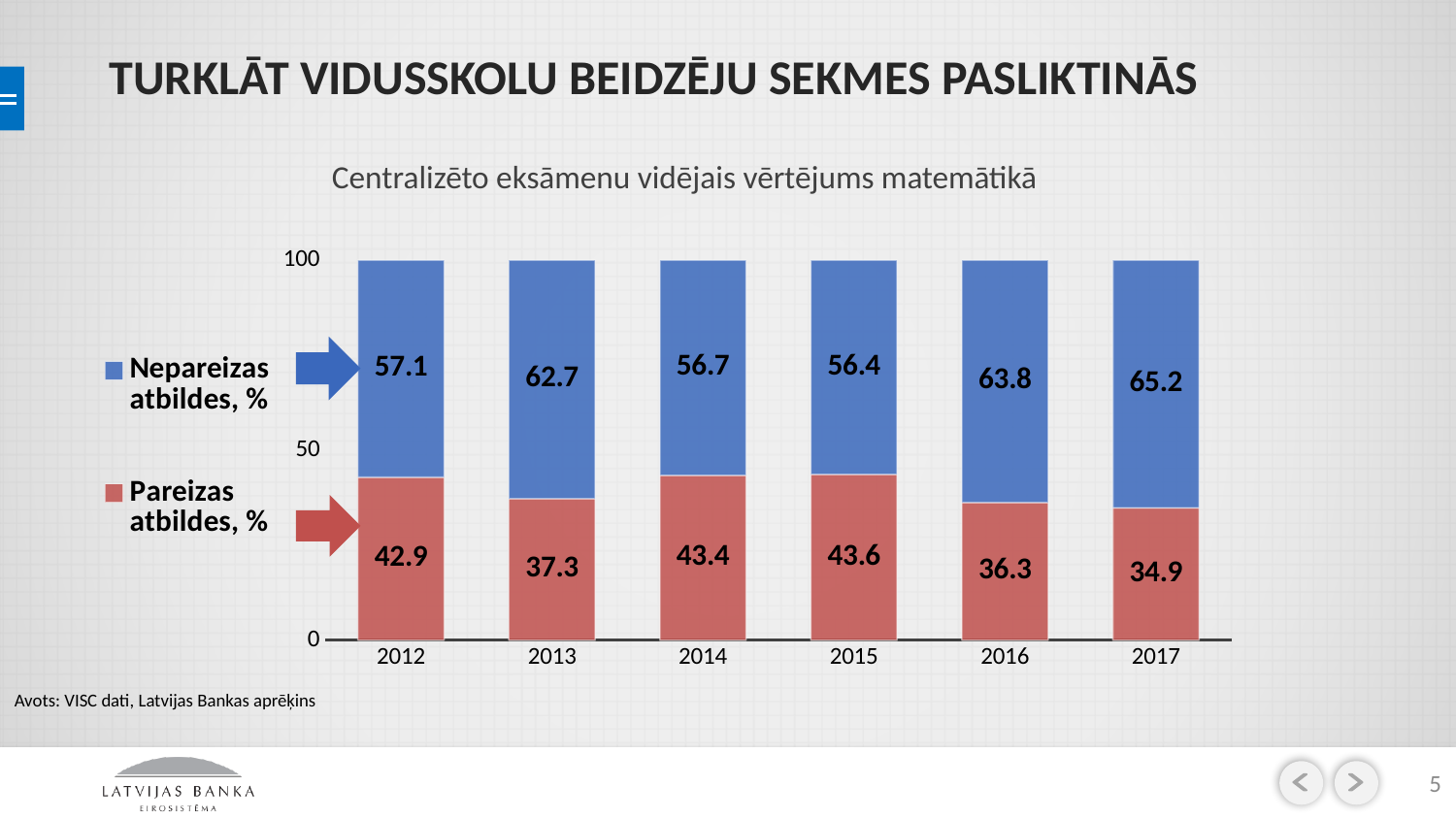
What is the difference between the Pareizas atbildes, % values for 2012 and 2017? 8.0 How many series does the legend list? 2 How many years are shown on the x axis? 6 What kind of chart is shown on the slide? stacked bar chart What is the value for Pareizas atbildes, % in 2015? 43.6 Which is larger: Pareizas atbildes, % in 2014 or in 2016? 2014 Is the value for Nepareizas atbildes, % in 2016 greater or less than 50? greater Which year has the highest value for Nepareizas atbildes, %? 2017 Which year has the lowest value for Pareizas atbildes, %? 2017 What is the value for Nepareizas atbildes, % in 2013? 62.7 What is the total of the stacked bar for 2014? 100.1 What is the title of the chart? Centralizēto eksāmenu vidējais vērtējums matemātikā